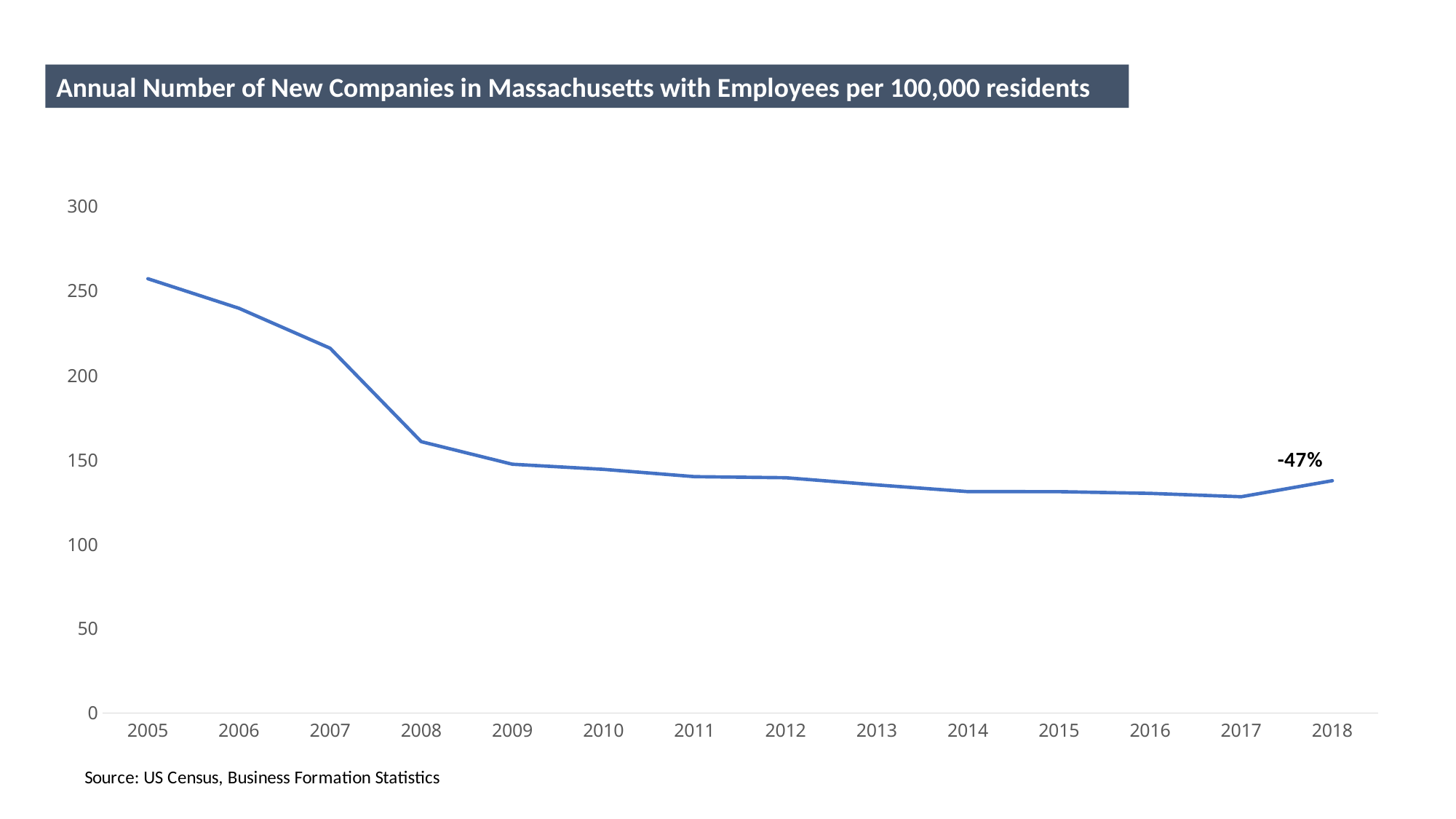
Is the value for 2006 greater or less than 250? less What percentage change is annotated at the end of the line? -47% Which year has the highest value? 2005 How many years are plotted on the x axis? 14 Which is larger, the value for 2007 or the value for 2009? 2007 Is the value for 2005 greater or less than 250? greater What kind of chart is shown on the slide? line chart Is the value for 2018 greater or less than 150? less Do the values generally rise or fall from 2005 to 2018? fall